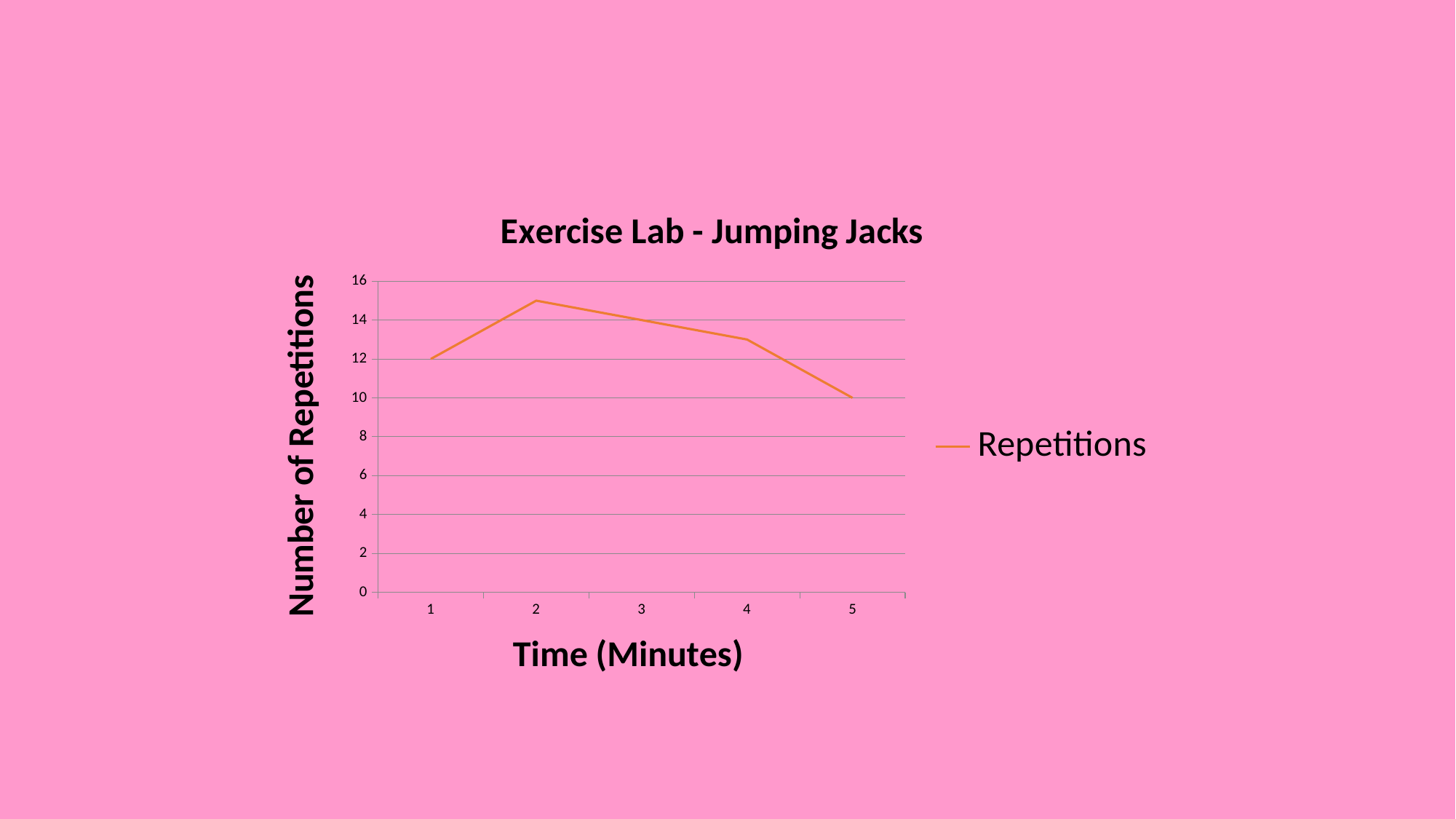
What is the number of repetitions at minute 5? 10 Is the number of repetitions at minute 2 greater or less than 14? greater What kind of chart is shown on the slide? line chart What is the number of repetitions at minute 3? 14 At which minute is the number of repetitions lowest? 5 Do the repetitions rise or fall from minute 2 to minute 5? fall What is the difference in repetitions between minute 3 and minute 5? 4 What is the title of the chart? Exercise Lab - Jumping Jacks How many series does the legend list? 1 At which minute is the number of repetitions highest? 2 How many data points are plotted on the line? 5 What is the number of repetitions at minute 1? 12